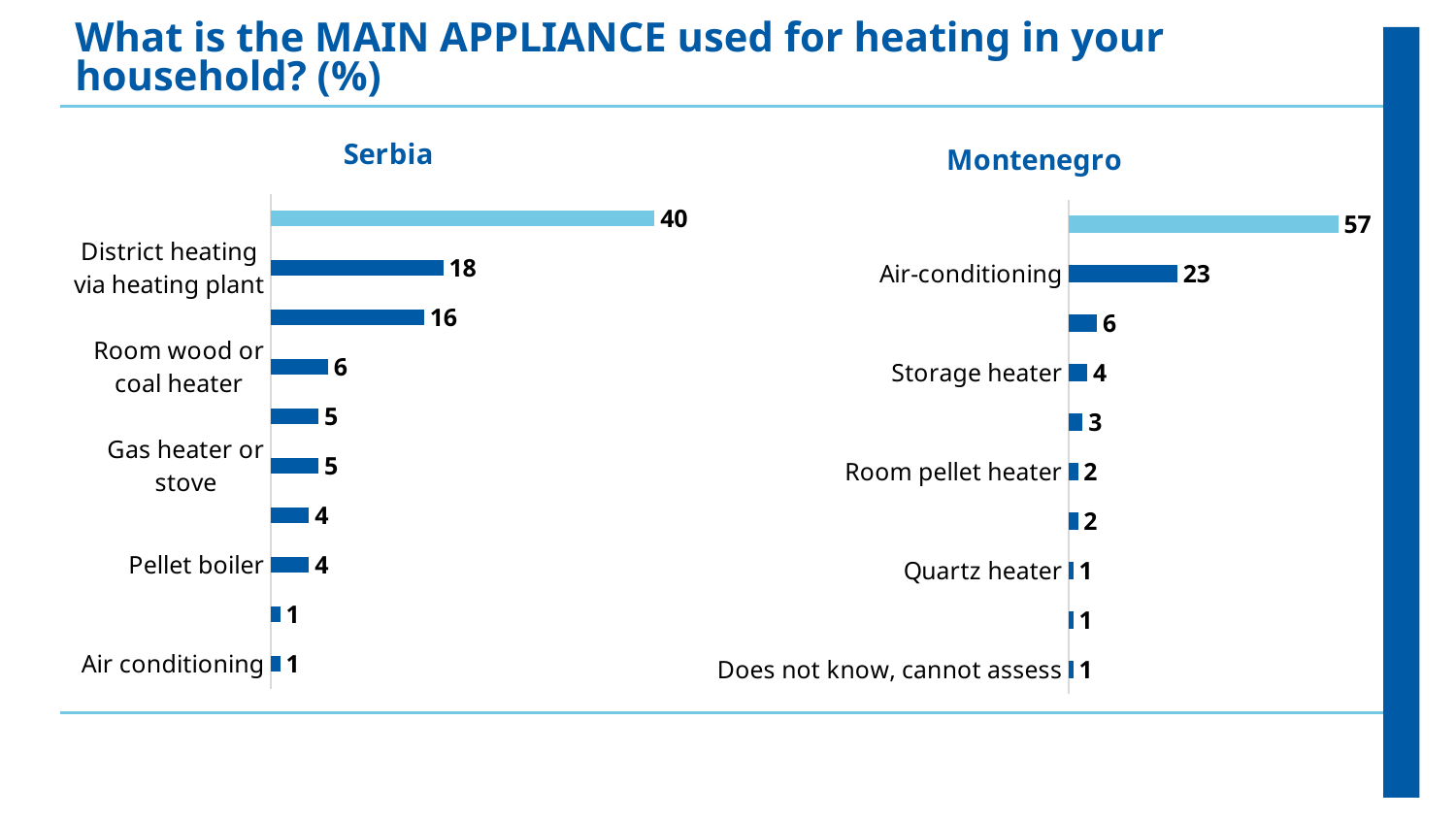
In the Serbia chart, what is the value for Room wood or coal heater? 6 Which is larger: Air-conditioning in the Montenegro chart or District heating via heating plant in the Serbia chart? Air-conditioning in the Montenegro chart In the Montenegro chart, what is the value for Air-conditioning? 23 In the Serbia chart, what is the value for District heating via heating plant? 18 In the Serbia chart, what is the highest value shown on any bar? 40 In the Montenegro chart, what is the value for Room pellet heater? 2 In the Serbia chart, what is the difference between the values for District heating via heating plant and Gas heater or stove? 13 In the Montenegro chart, what is the value for Storage heater? 4 What kind of chart is the Serbia chart? Bar chart In the Serbia chart, what is the value for Air conditioning? 1 In the Serbia chart, what is the value for Pellet boiler? 4 In the Montenegro chart, what is the highest value shown on any bar? 57